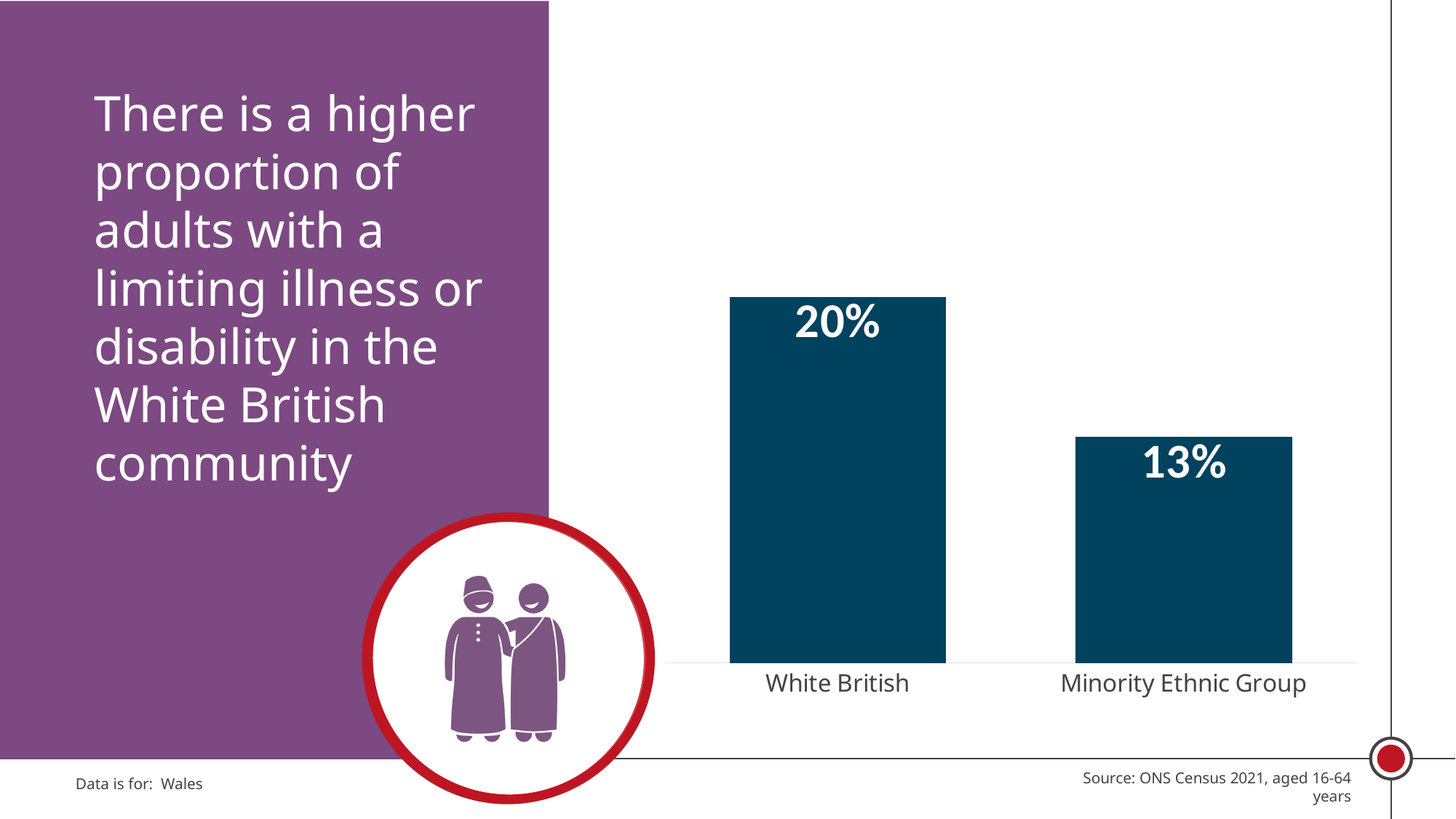
What is the value for White British? 20% Which category has the highest value? White British What colour are the bars in the chart? Dark blue Which category has the lowest value? Minority Ethnic Group How many categories are shown in the chart? 2 Do the values rise or fall from left to right across the categories? Fall What is the difference between the values for White British and Minority Ethnic Group? 7% What kind of chart is shown on the slide? Bar chart Which category is shown on the left of the chart? White British What is the value for Minority Ethnic Group? 13% Which is larger, the value for White British or the value for Minority Ethnic Group? White British